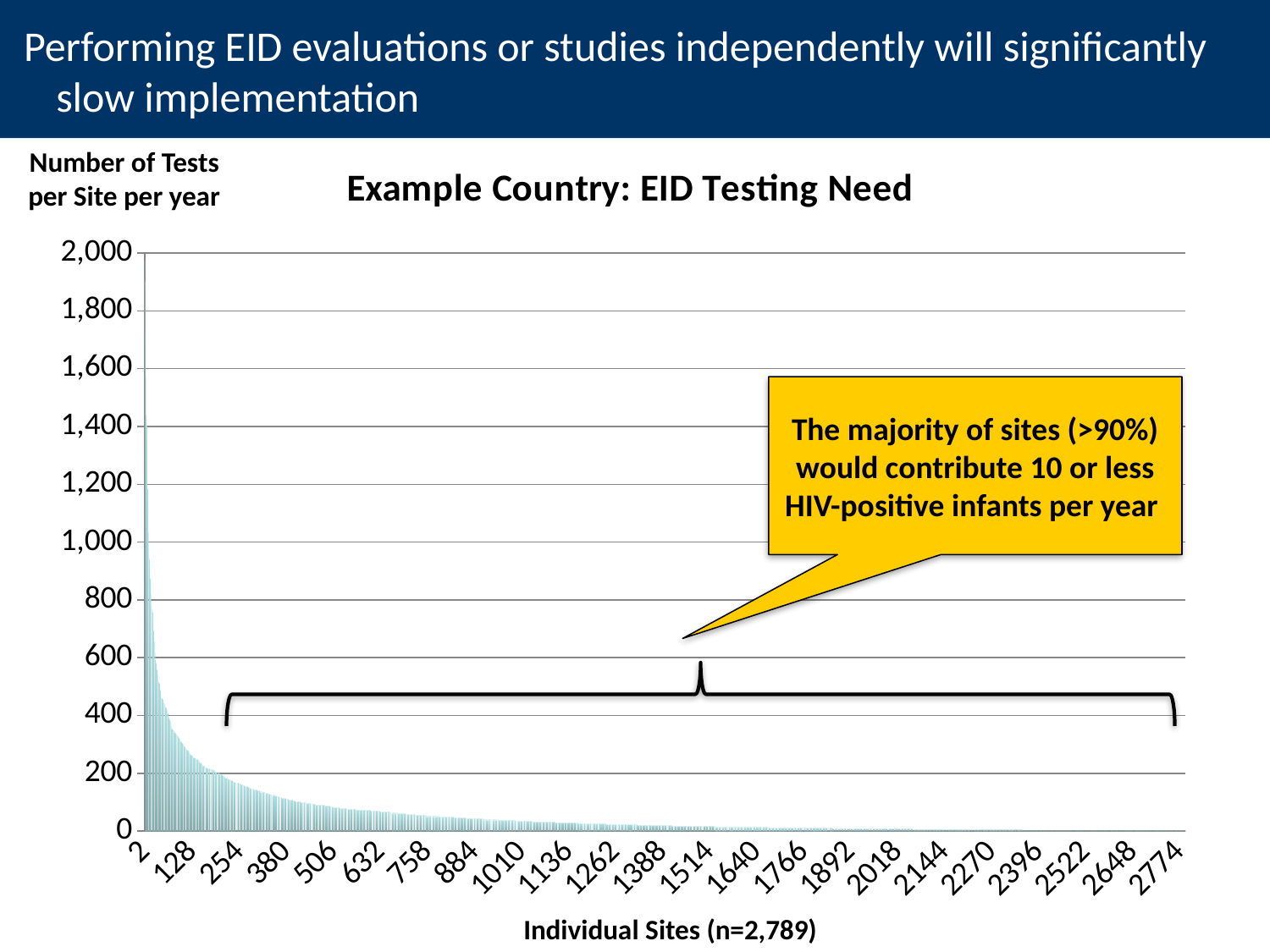
What kind of chart is shown on the slide? bar chart How many individual sites does the x-axis label say are plotted? 2,789 What is the highest value shown on the vertical axis? 2,000 Is the value for site 128 greater or less than 600? less What is the label of the vertical axis of the chart? Number of Tests per Site per year Do the values rise or fall as you move from left to right along the x axis? fall Is the value for the first site (site 2) greater or less than 1,000? greater What is the title of the chart? Example Country: EID Testing Need Which site has the highest number of tests per year, the first site on the left or the last site on the right? the first site on the left Is the value for site 1514 greater or less than 200? less